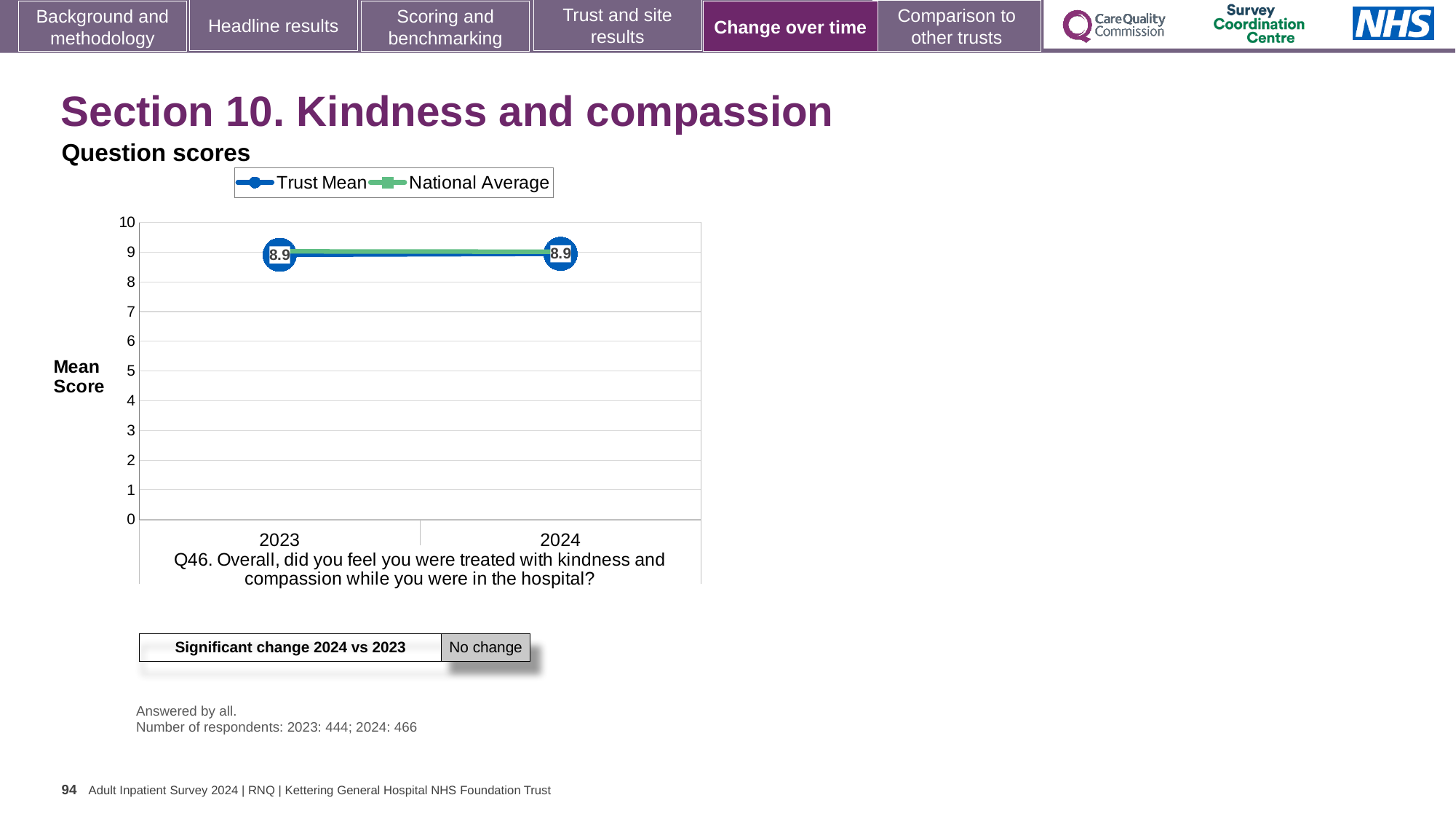
How many years are plotted on the x axis? 2 Is the National Average for 2023 greater or less than 5? greater What kind of chart is shown? line chart Which series is shown in green in the legend? National Average What is the label of the y axis? Mean Score Does the Trust Mean rise, fall or stay the same from 2023 to 2024? stays the same What is the Trust Mean score for 2024? 8.9 What is the Trust Mean score for 2023? 8.9 What is the difference between the Trust Mean scores for 2024 and 2023? 0 How many series does the legend list? 2 Is the Trust Mean score for 2024 greater or less than 8? greater